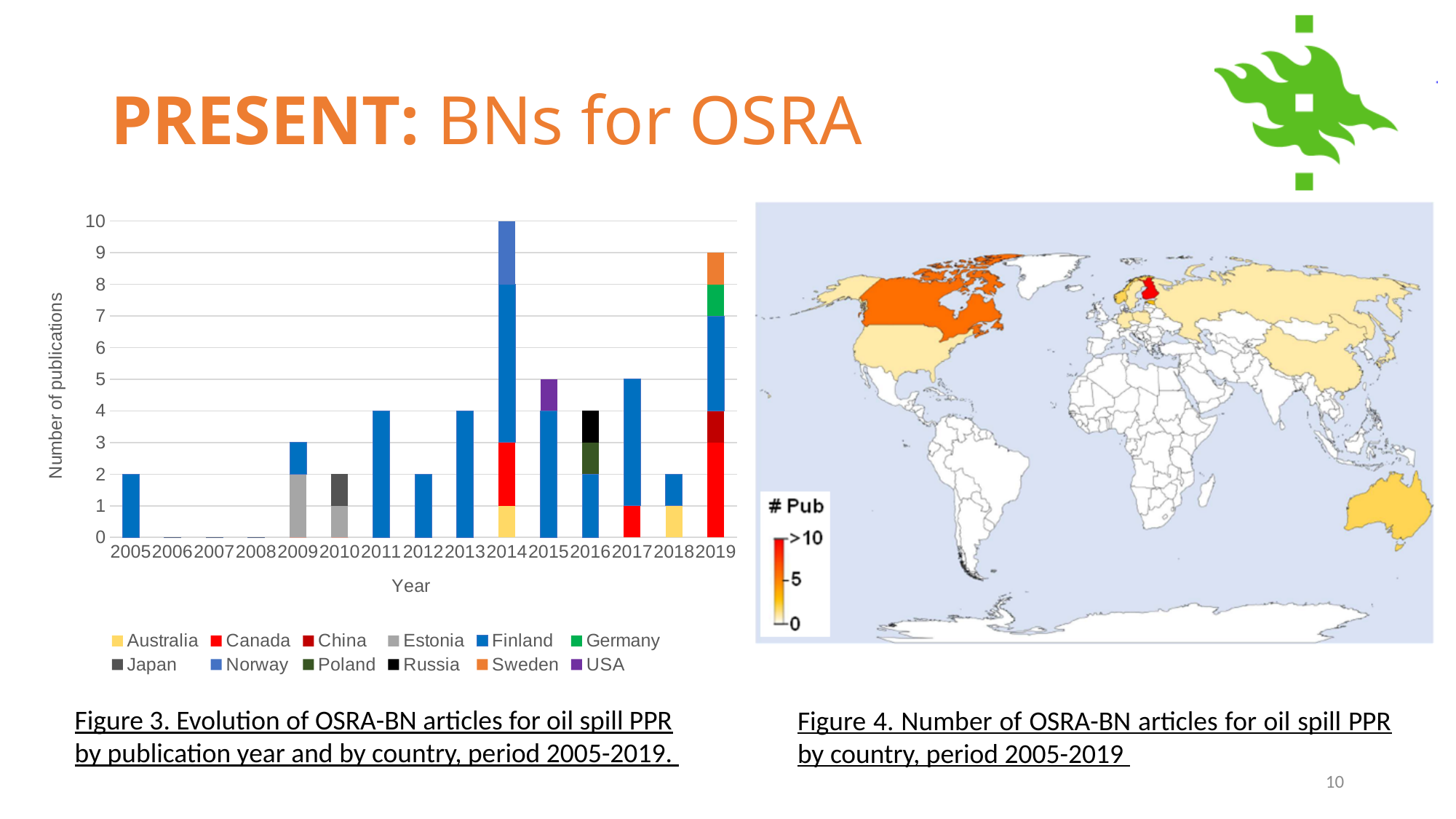
In Figure 3, what is the total number of publications in 2011? 4 In Figure 3, what is the difference between the total publications in 2014 and in 2019? 1 In Figure 3, which year has the highest total number of publications? 2014 In Figure 3, is the total number of publications in 2017 greater or less than 3? greater In Figure 3, which year has more total publications, 2015 or 2018? 2015 In Figure 3, what kind of chart is used to show the number of publications by year? stacked bar chart In Figure 3, how many years are shown on the x axis? 15 In Figure 3, which country appears in the most years? Finland In Figure 3, what is the total number of publications in 2019? 9 In Figure 3, how many countries does the legend list? 12 In Figure 3, what is the total number of publications in 2014? 10 In Figure 3, what is the label of the y axis? Number of publications